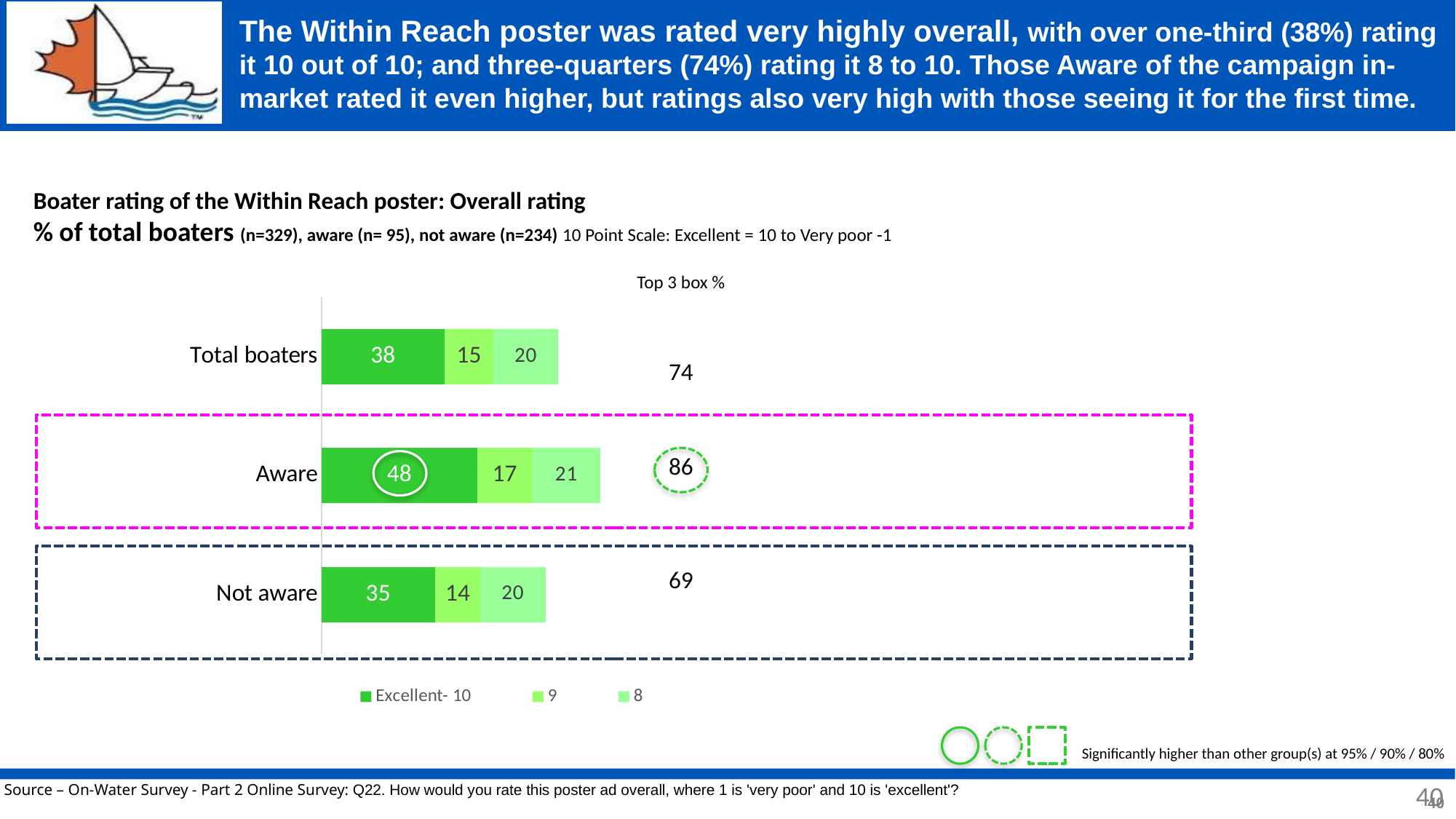
Which category has the highest 'Excellent- 10' value? Aware How many categories are shown on the chart? 3 What is the '8' value for Total boaters? 20 Which category has the lowest Top 3 box %? Not aware What is the 'Excellent- 10' value for Aware? 48 What is the total of the stacked bar for Total boaters? 73 What kind of chart is shown? Stacked bar chart What is the '9' value for Not aware? 14 What is the Top 3 box % for Aware? 86 Which is larger, the '9' value for Aware or the '9' value for Total boaters? Aware What is the difference between the 'Excellent- 10' values for Aware and Not aware? 13 How many series does the legend list? 3